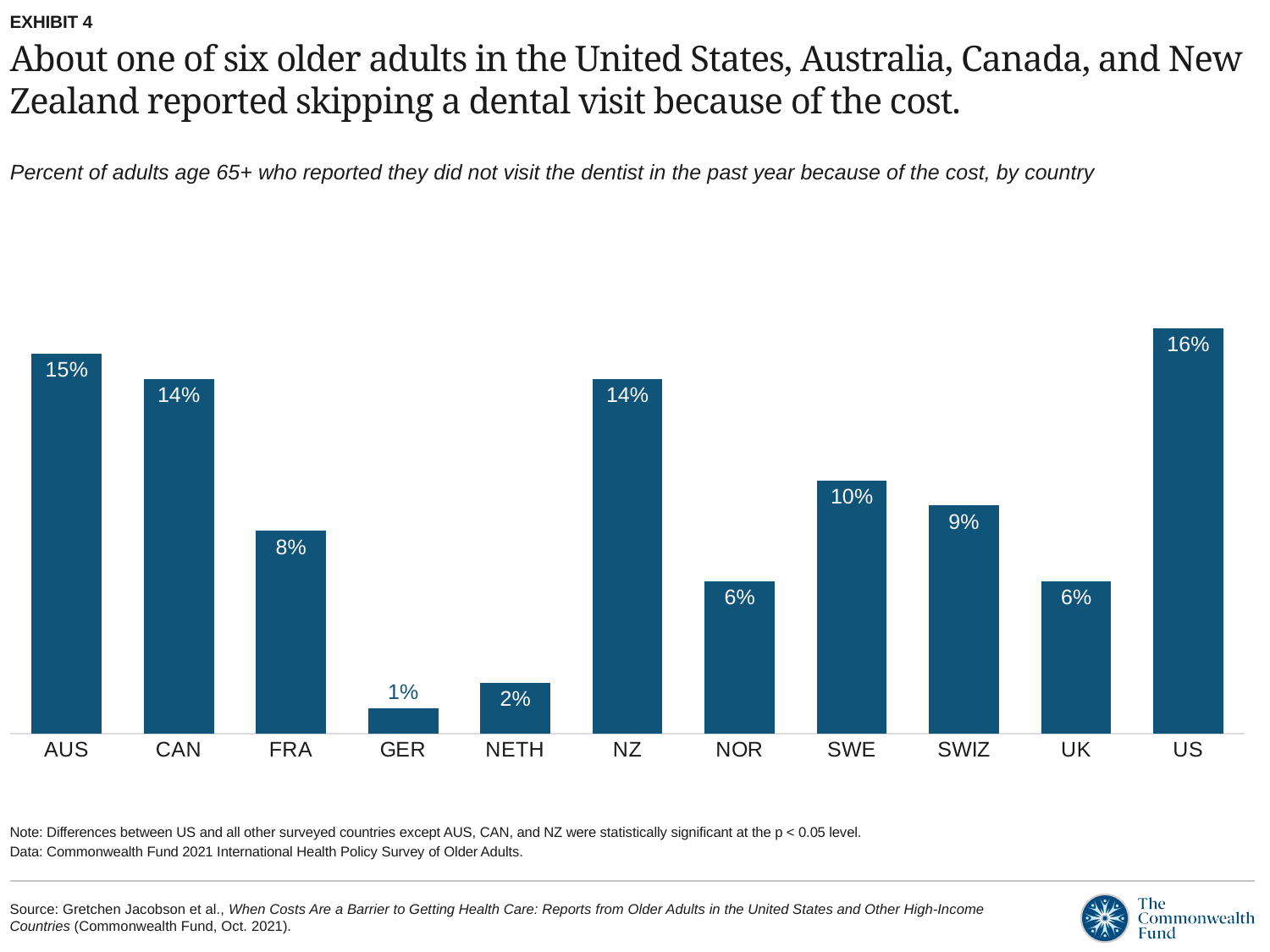
What is the difference between the values for SWE and NETH? 8% Which is larger, the value for SWIZ or the value for NOR? SWIZ What is the value for the US? 16% What kind of chart is shown on the slide? Bar chart What is the value for FRA? 8% What is the difference between the values for the US and AUS? 1% Which country has the lowest value? GER How many countries are shown in the chart? 11 What is the exhibit number shown on the slide? Exhibit 4 Which country has the highest value? US Which two countries share the same value of 14%? CAN and NZ What is the value for SWE? 10%